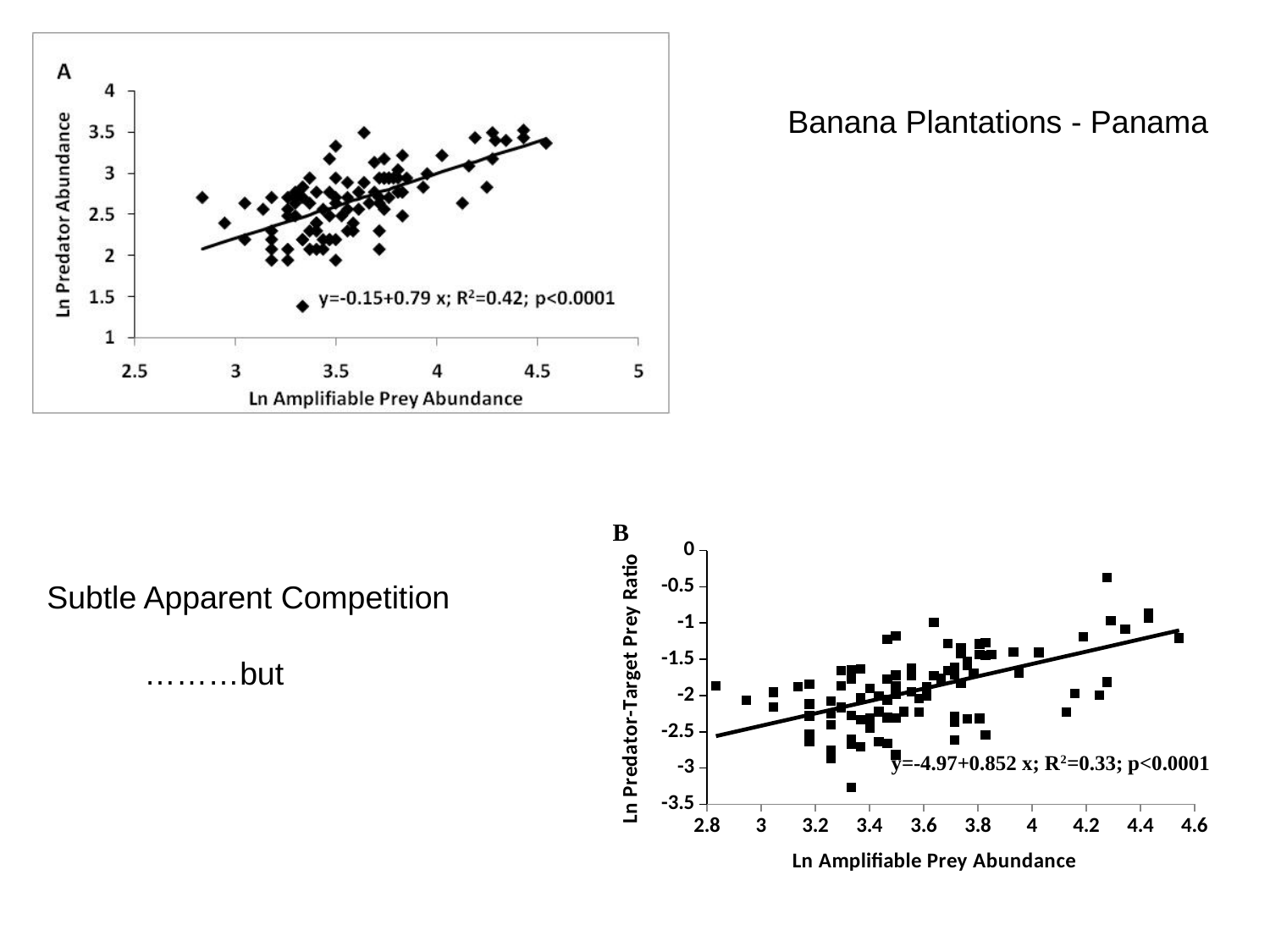
What kind of chart is chart B at the bottom right of the slide? Scatter plot Which chart has the higher R² value, chart A or chart B? Chart A What regression equation is printed on chart A? y=-0.15+0.79 x What is the y-axis label of chart B? Ln Predator-Target Prey Ratio In chart A, does Ln Predator Abundance tend to rise or fall as Ln Amplifiable Prey Abundance increases? Rise What kind of chart is chart A at the top left of the slide? Scatter plot What regression equation is printed on chart B? y=-4.97+0.852 x What is the R² value printed on chart B? 0.33 What is the difference between the R² values of chart A and chart B? 0.09 What is the x-axis label of chart A? Ln Amplifiable Prey Abundance In chart B, does Ln Predator-Target Prey Ratio tend to rise or fall as Ln Amplifiable Prey Abundance increases? Rise What is the R² value printed on chart A? 0.42